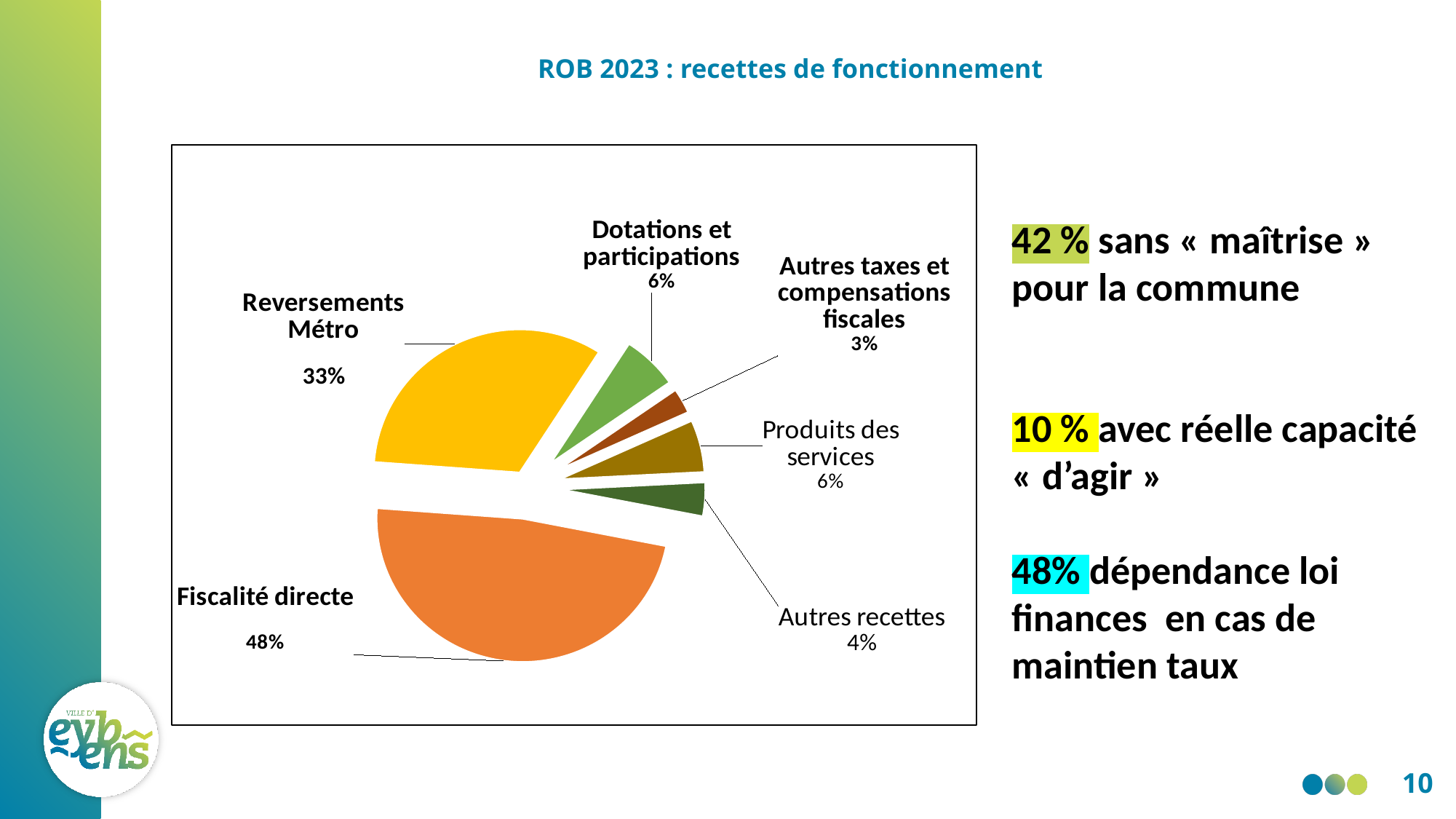
What kind of chart is shown on the slide? pie chart What is the value shown for Autres recettes? 4% What share of the pie does Reversements Métro represent? 33% What is the difference between the shares of Fiscalité directe and Reversements Métro? 15% Which category has the largest slice of the pie? Fiscalité directe Which category has the smallest slice of the pie? Autres taxes et compensations fiscales What is the value shown for Autres taxes et compensations fiscales? 3% How many slices does the pie chart have? 6 What is the value shown for Dotations et participations? 6% Which is larger, the share for Autres recettes or the share for Autres taxes et compensations fiscales? Autres recettes What share of the pie does Fiscalité directe represent? 48% What is the value shown for Produits des services? 6%